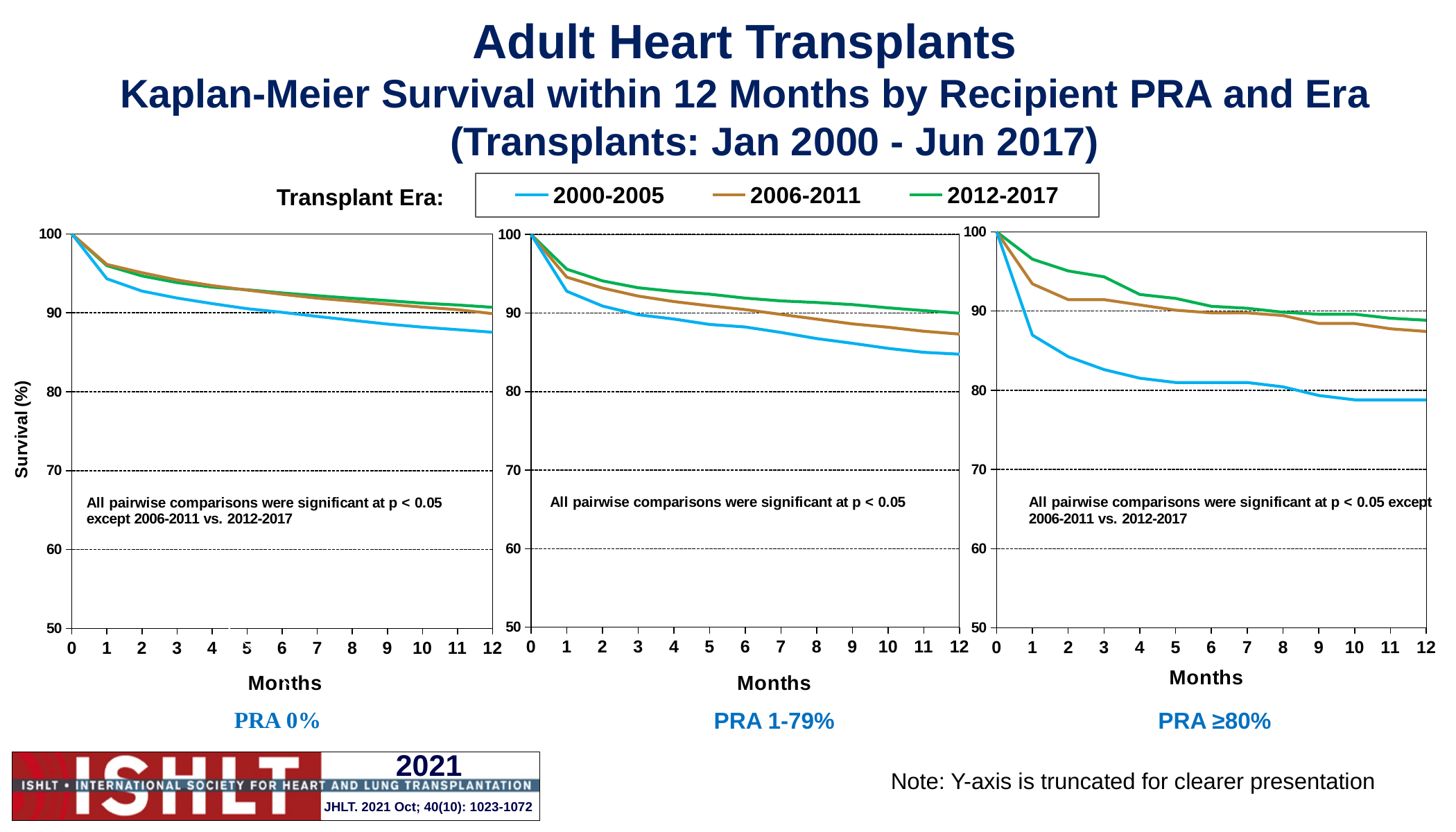
How many transplant eras does the legend list? 3 In the PRA 1-79% chart, which era has the highest survival at 12 months? 2012-2017 What is the label of the y-axis on the slide? Survival (%) In the PRA 0% chart, is the 2000-2005 survival value at 12 months greater or less than 90? less How many separate survival charts are shown on the slide? 3 In the PRA ≥80% chart, what is the survival value for all eras at month 0? 100 In the PRA ≥80% chart, is the 2000-2005 survival value at 12 months greater or less than 80? less In the PRA ≥80% chart, does survival for the 2000-2005 era rise or fall as months increase? Fall What type of chart is used in the PRA 0% panel? Line chart In the PRA ≥80% chart, which era has the lowest survival at 12 months? 2000-2005 In the PRA 1-79% chart, is the 2000-2005 survival value at 12 months greater or less than 90? less In the PRA ≥80% chart, at 12 months, which is larger: survival for 2012-2017 or for 2000-2005? 2012-2017